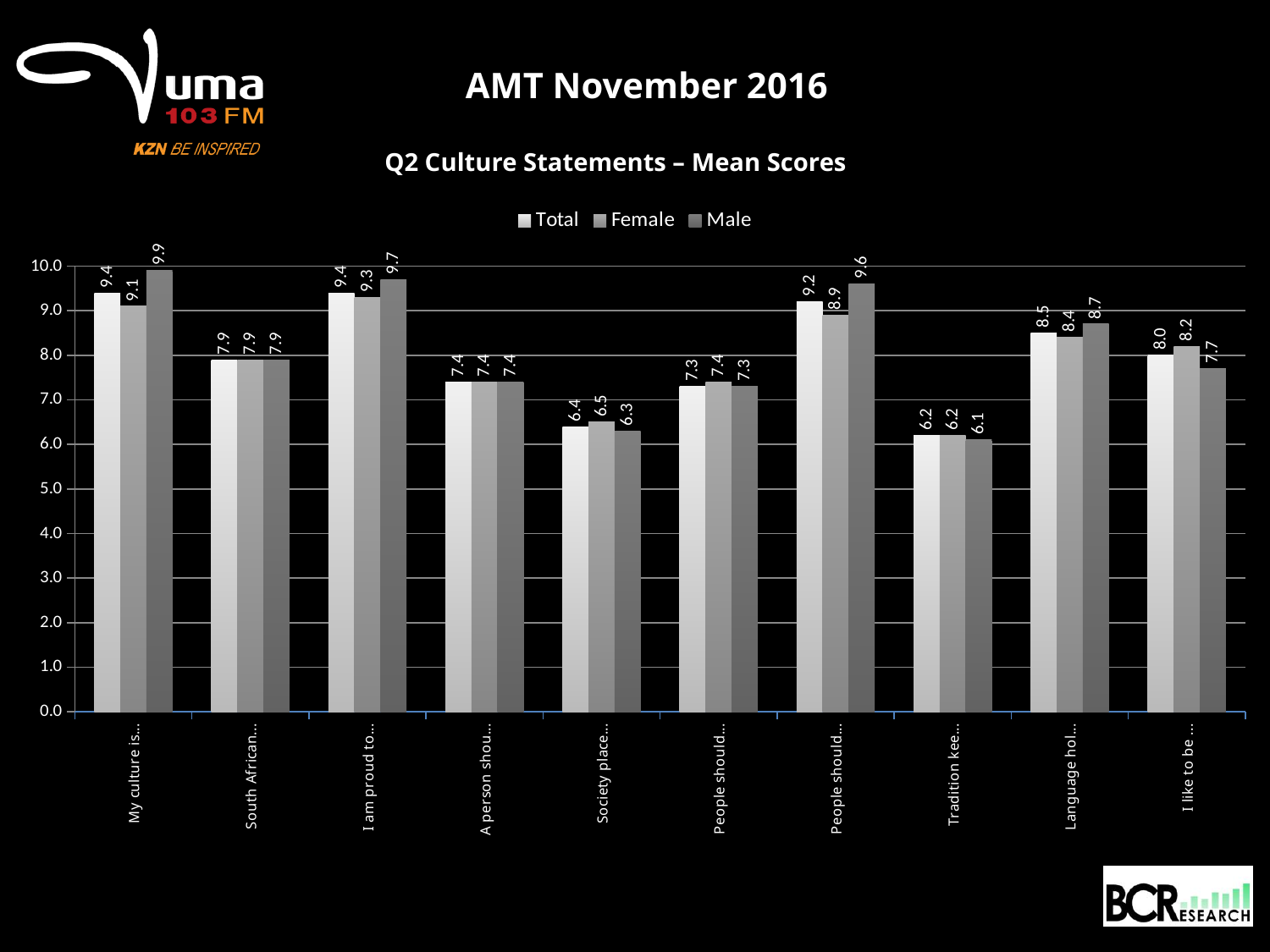
What is the title of the chart? Q2 Culture Statements – Mean Scores Is the Total mean score for the statement beginning "Tradition kee..." greater or less than 7.0? less For the statement beginning "I like to be ...", which is larger, the Female or the Male mean score? Female Which statement has the highest Male mean score? My culture is... Which statement has the lowest Male mean score? Tradition kee... How many categories (culture statements) are plotted on the x axis? 10 What is the Female mean score for the statement beginning "Society place..."? 6.5 What type of chart is shown on the slide? bar chart How many series does the legend list? 3 What is the Total mean score for the statement beginning "Language hol..."? 8.5 What is the Male mean score for the statement beginning "My culture is..."? 9.9 What is the difference between the Male and Female mean scores for the statement beginning "My culture is..."? 0.8